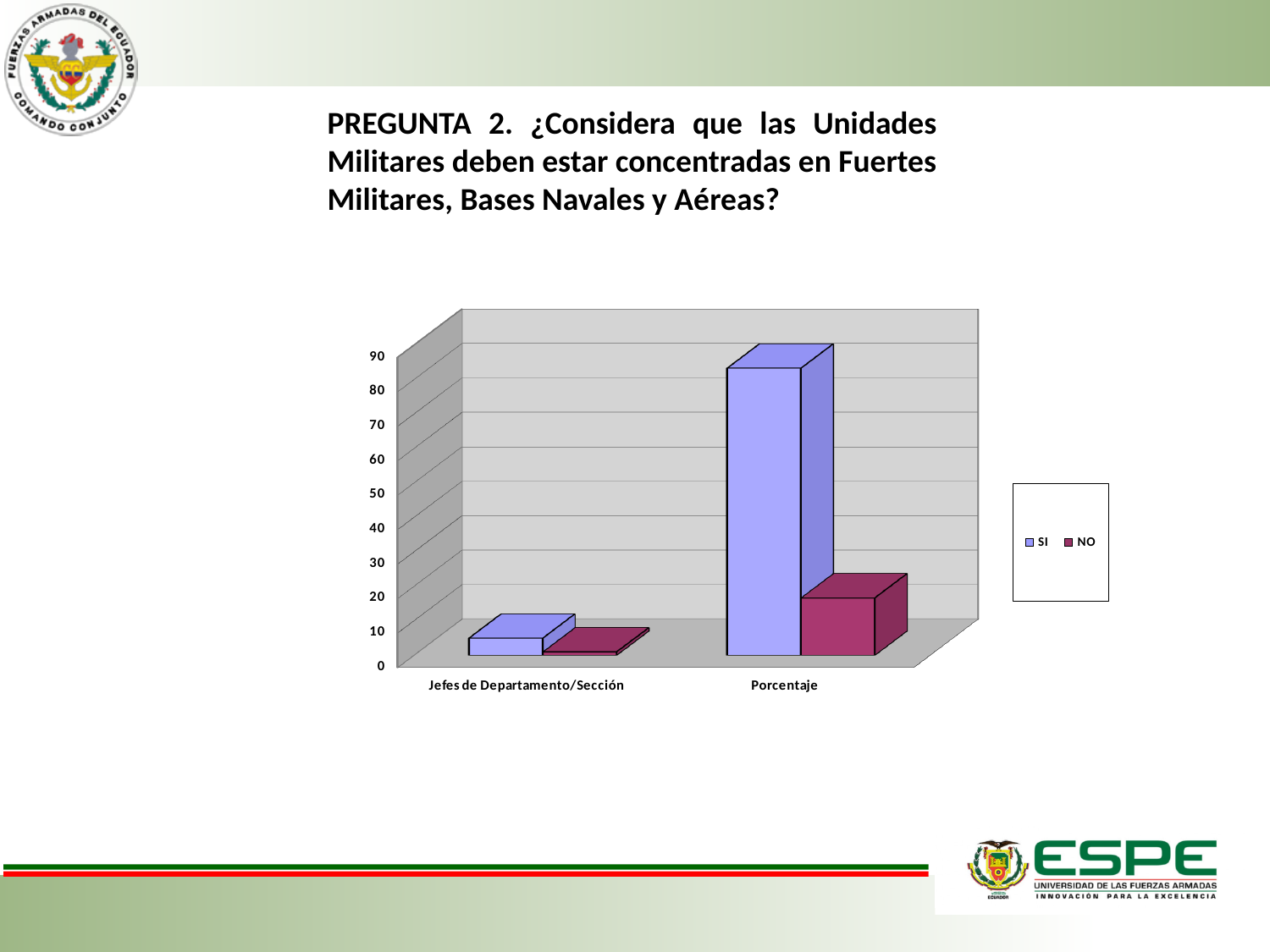
What kind of chart is shown on the slide? bar chart What are the two series named in the legend? SI and NO Is the NO value for Porcentaje greater or less than 30? less Is the SI value for Jefes de Departamento/Sección greater or less than 20? less Which category and series has the tallest bar? SI for Porcentaje For Porcentaje, which is larger, SI or NO? SI How many series does the legend list? 2 Which category and series has the shortest bar? NO for Jefes de Departamento/Sección How many categories are shown on the x axis? 2 For Jefes de Departamento/Sección, which is larger, SI or NO? SI Is the SI value for Porcentaje greater or less than 70? greater What colour are the bars for the SI series? blue